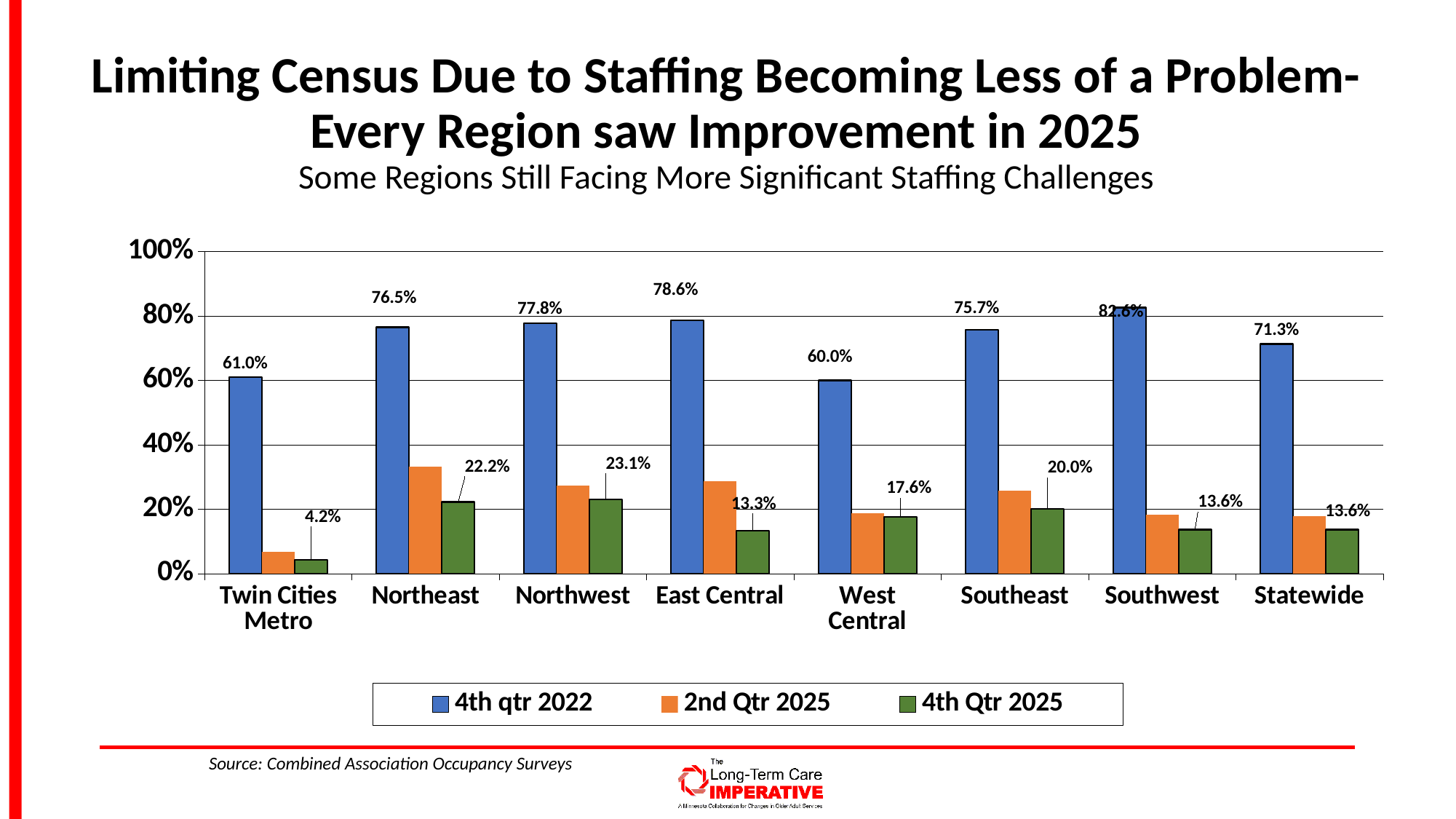
Is the 2nd Qtr 2025 value for Northeast greater or less than 20%? greater How many series does the legend list? 3 What is the 4th qtr 2022 value for East Central? 78.6% What is the difference between the 4th qtr 2022 and 4th Qtr 2025 values for Statewide? 57.7% Which is larger, the 4th Qtr 2025 value for Northeast or for East Central? Northeast How many regions are shown on the x axis? 8 What is the 4th Qtr 2025 value for Twin Cities Metro? 4.2% Which region has the highest 4th Qtr 2025 value? Northwest What is the 4th Qtr 2025 value for Southeast? 20.0% What kind of chart is shown on the slide? Bar chart Which region has the lowest 4th Qtr 2025 value? Twin Cities Metro Which region has the highest 4th qtr 2022 value? Southwest